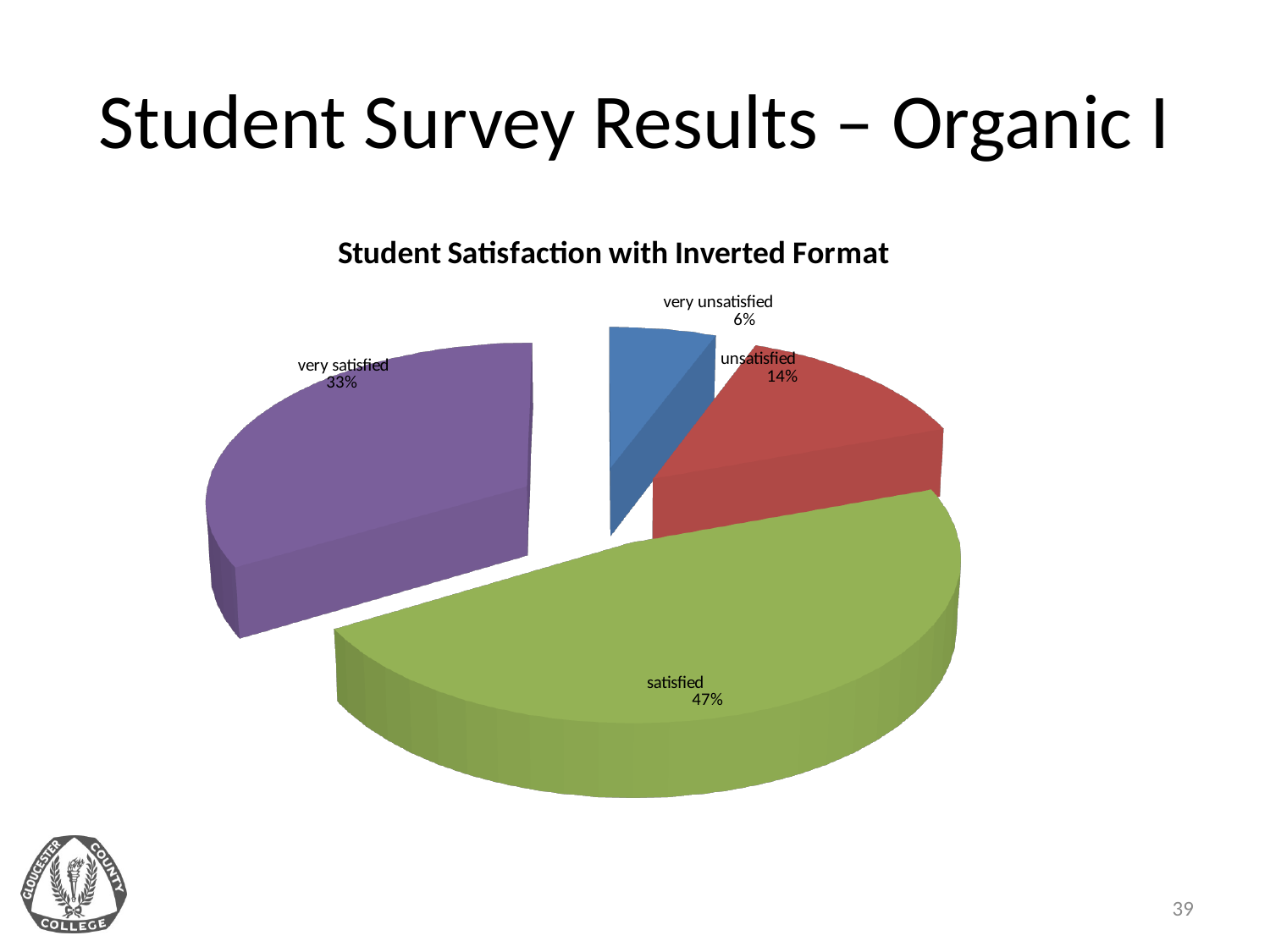
What is the title of the chart? Student Satisfaction with Inverted Format What percentage of students were very satisfied? 33% How many categories are shown in the pie chart? 4 What percentage of students were unsatisfied? 14% What colour is the satisfied slice? green Which is larger, the unsatisfied slice or the very unsatisfied slice? unsatisfied What percentage of students were satisfied with the inverted format? 47% Which category has the largest share of the pie? satisfied Which category has the smallest share of the pie? very unsatisfied What kind of chart is shown on the slide? pie chart What is the difference in percentage points between the satisfied and very satisfied slices? 14 What percentage of students were very unsatisfied? 6%